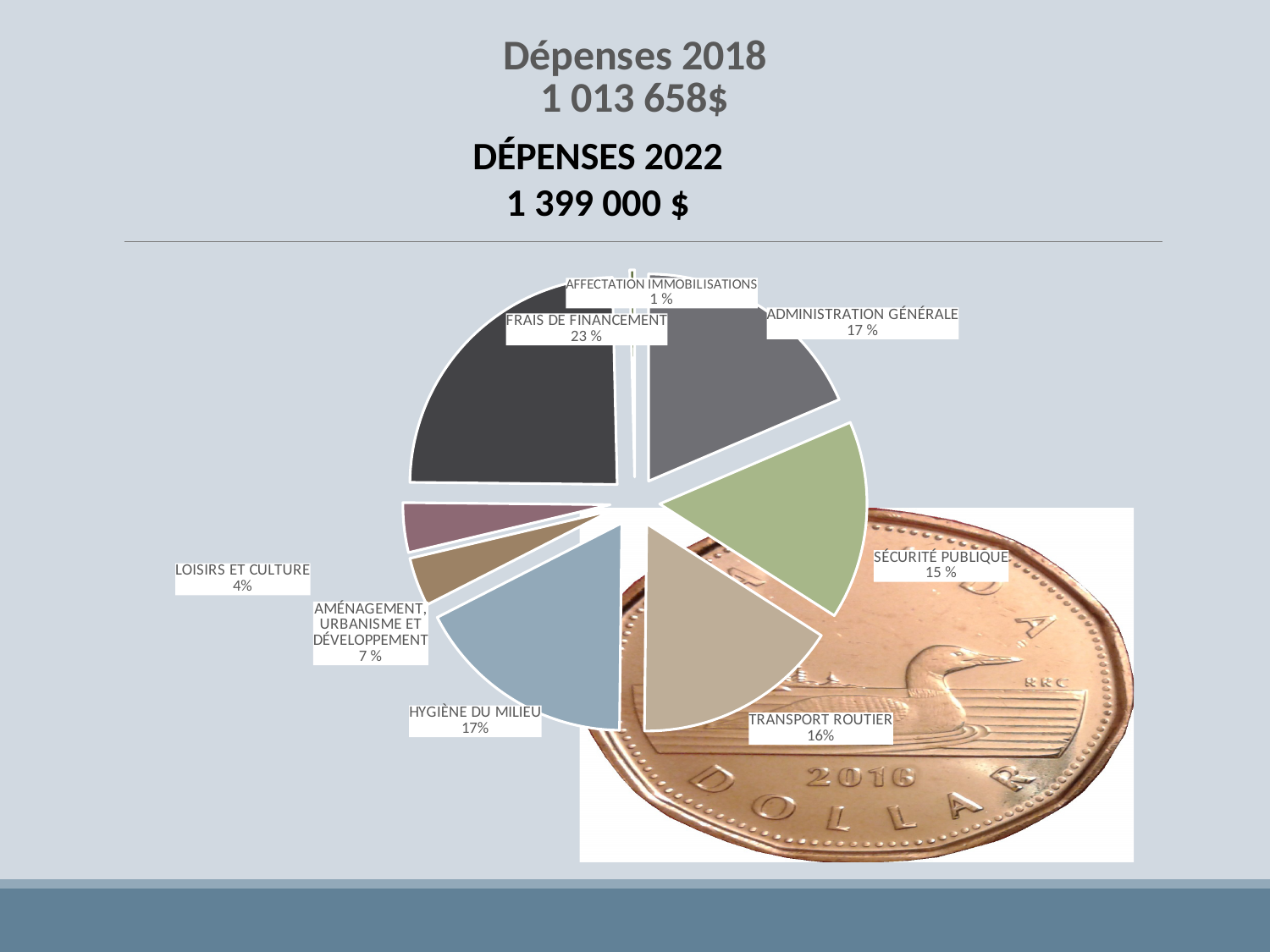
How many slices does the pie chart have? 8 What share of the pie does FRAIS DE FINANCEMENT represent? 23 % By how many percentage points does FRAIS DE FINANCEMENT exceed LOISIRS ET CULTURE? 19 What share of the pie does TRANSPORT ROUTIER represent? 16% What share of the pie does HYGIÈNE DU MILIEU represent? 17% Which category has the largest share of the pie? FRAIS DE FINANCEMENT Which is larger, the share for TRANSPORT ROUTIER or the share for SÉCURITÉ PUBLIQUE? TRANSPORT ROUTIER What kind of chart is shown on the slide? Pie chart Which category has the smallest share of the pie? AFFECTATION IMMOBILISATIONS